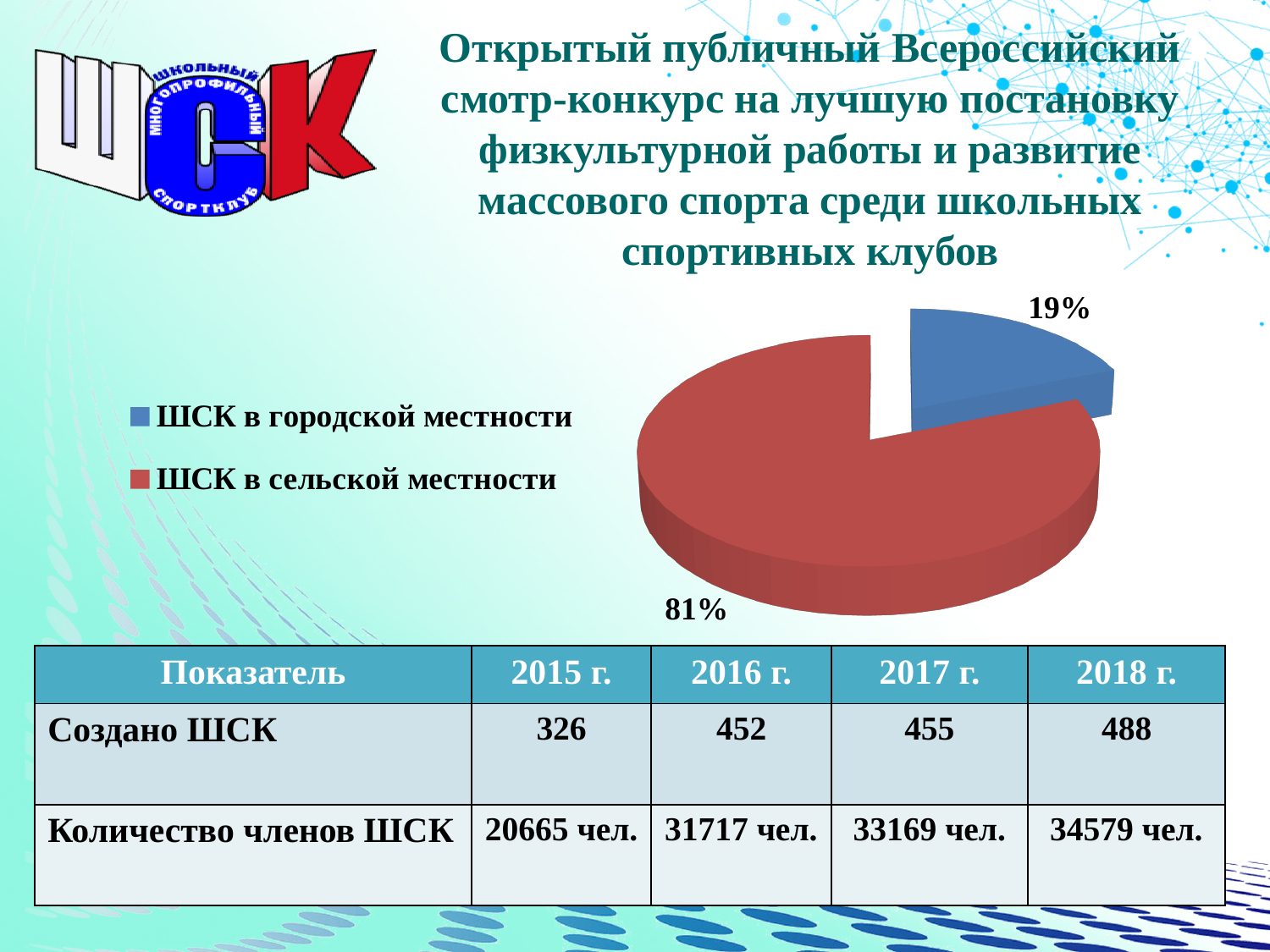
How many entries does the legend of the pie chart list? 2 Which is larger in the pie chart: ШСК в городской местности or ШСК в сельской местности? ШСК в сельской местности Which category has the smallest slice in the pie chart? ШСК в городской местности What is the difference in percentage points between the ШСК в сельской местности slice and the ШСК в городской местности slice? 62 How many slices does the pie chart have? 2 What kind of chart is shown on the slide? pie chart What colour is the ШСК в городской местности slice in the pie chart? blue What share of the pie chart is ШСК в городской местности? 19% What colour is the ШСК в сельской местности slice in the pie chart? red Which category has the largest slice in the pie chart? ШСК в сельской местности What share of the pie chart is ШСК в сельской местности? 81%